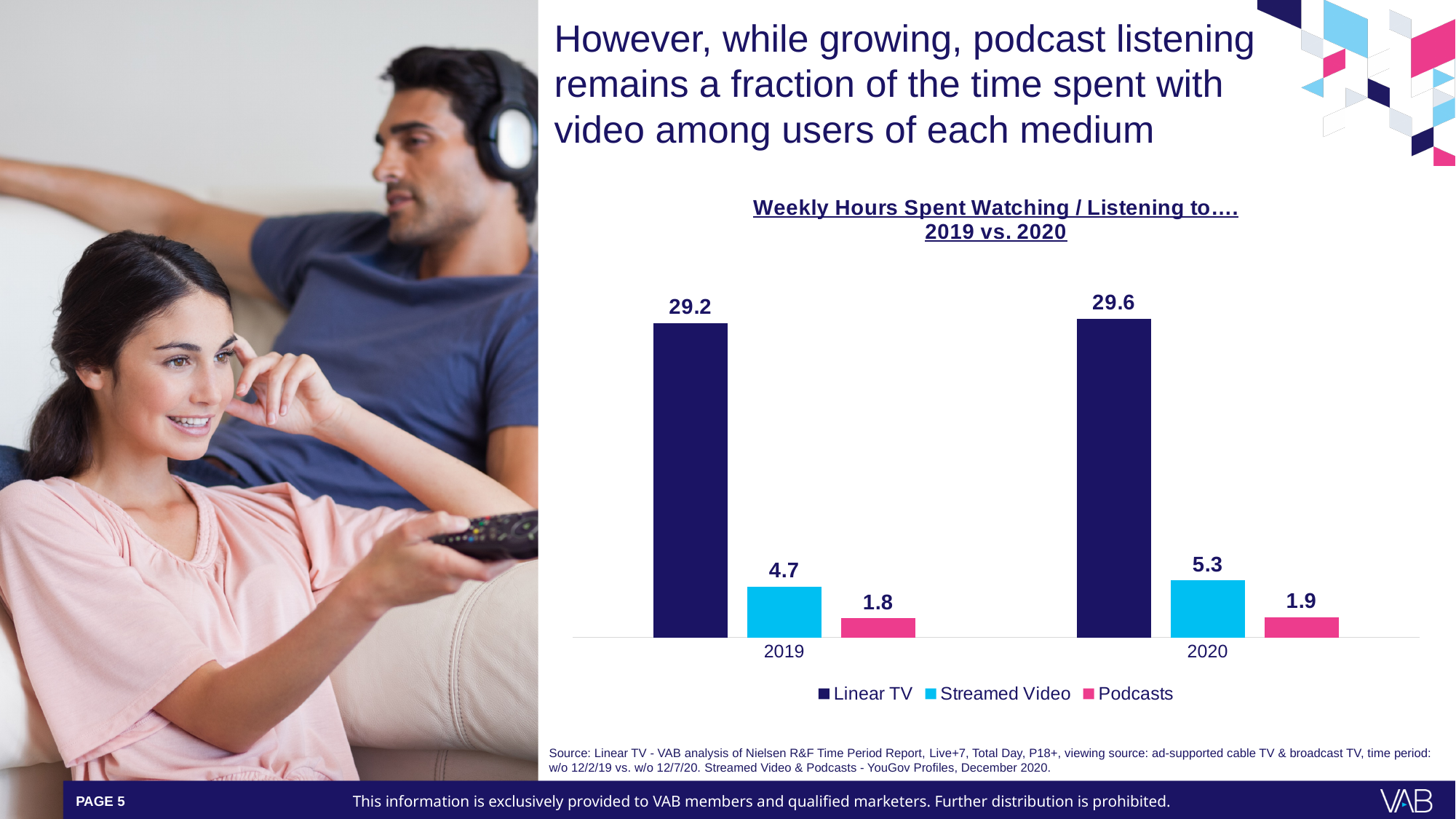
What is the value for Podcasts in 2019? 1.8 Which is larger: Podcasts in 2020 or Podcasts in 2019? Podcasts in 2020 What is the value for Streamed Video in 2020? 5.3 Do the Linear TV values rise or fall from 2019 to 2020? Rise How many series does the legend list? 3 By how much did Streamed Video increase from 2019 to 2020? 0.6 Which series has the highest value in 2020? Linear TV What is the difference between Linear TV and Streamed Video in 2020? 24.3 How many year categories are shown on the x axis? 2 What kind of chart is shown on the slide? Bar chart Which series has the lowest value in 2019? Podcasts What is the value for Linear TV in 2019? 29.2